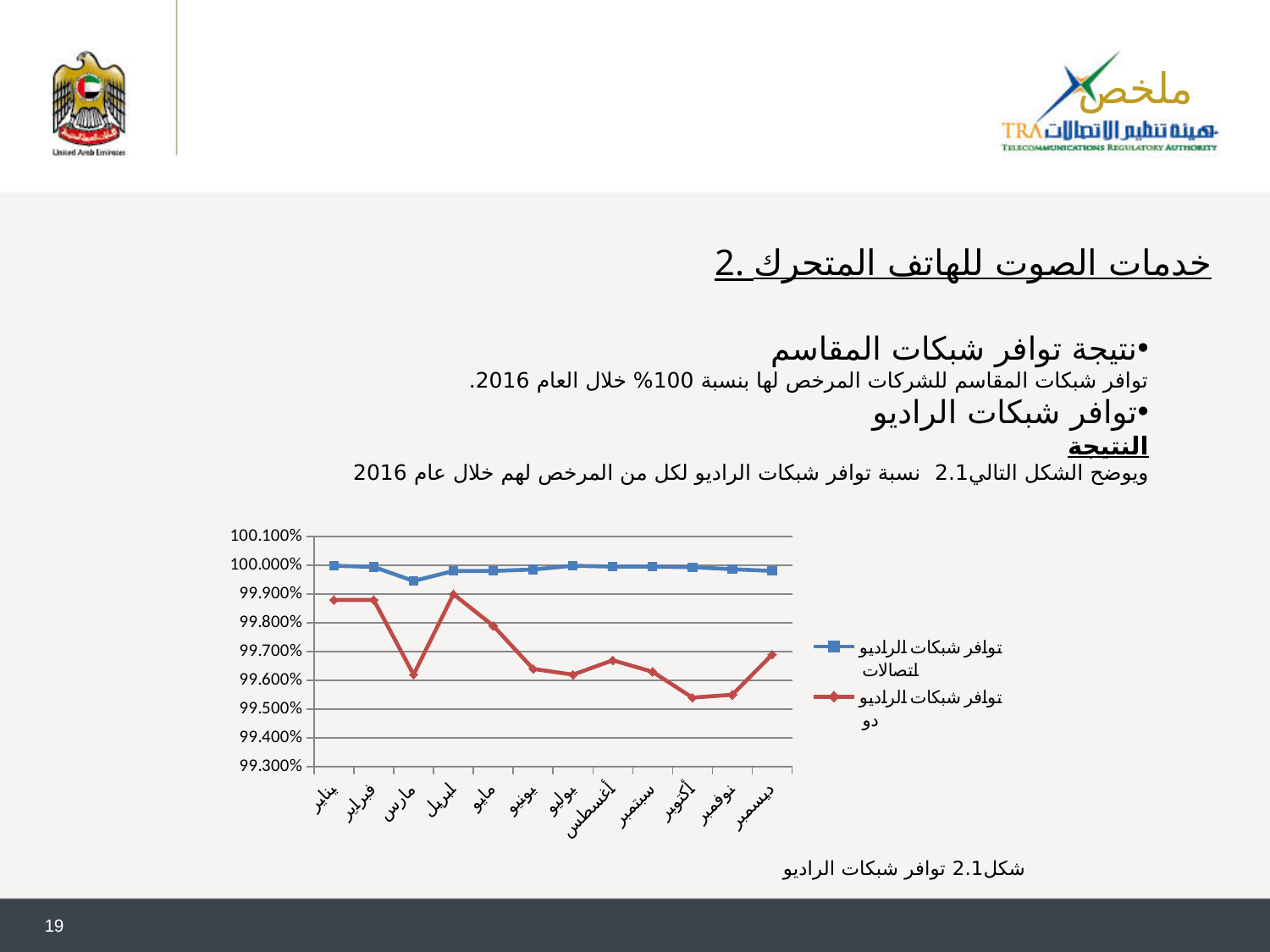
Does the توافر شبكات الراديو دو series rise or fall from فبراير to مارس? fall What is the caption written below the chart? شكل 2.1 توافر شبكات الراديو How many series does the chart legend list? 2 What kind of chart is shown on the slide? line chart Is the value for توافر شبكات الراديو اتصالات in يونيو greater or less than 99.900%? greater Which series is plotted higher across all months of the chart? توافر شبكات الراديو اتصالات Is the value for توافر شبكات الراديو دو in يناير greater or less than 99.800%? greater Is the value for توافر شبكات الراديو دو in مارس greater or less than 99.700%? less Which series has the higher value in مارس (March): توافر شبكات الراديو اتصالات or توافر شبكات الراديو دو? توافر شبكات الراديو اتصالات In which month does the توافر شبكات الراديو اتصالات series reach its lowest value? مارس How many months are plotted along the x axis of the chart? 12